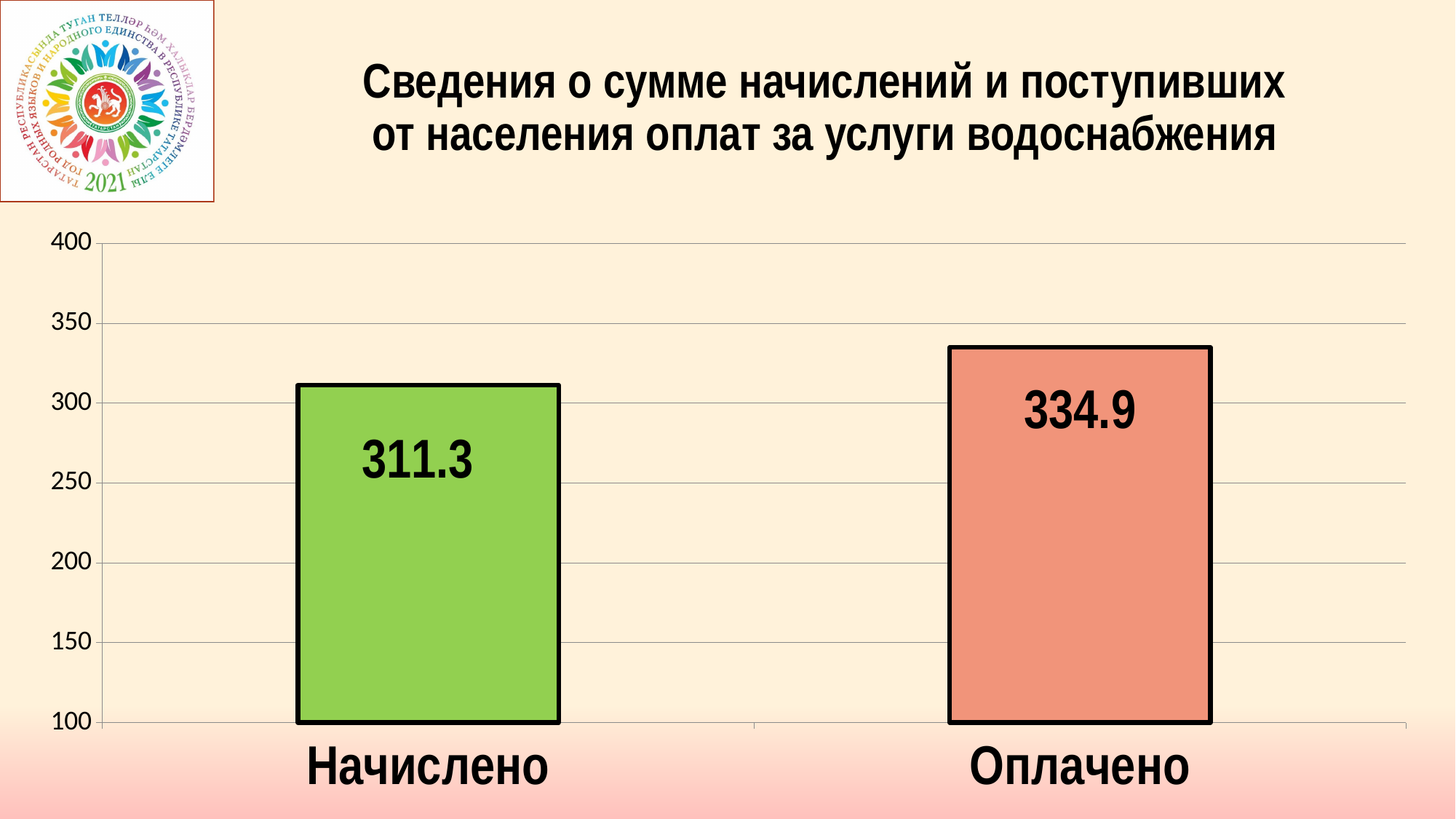
Which category has the highest value? Оплачено What kind of chart is shown on the slide? Bar chart Is the value for Начислено greater or less than 300? greater What is the value for Оплачено? 334.9 Which category has the lowest value? Начислено Is the value for Оплачено greater or less than 350? less Which is larger, the value for Начислено or the value for Оплачено? Оплачено What is the highest value shown on the vertical axis? 400 How many categories are shown in the chart? 2 What colour is the bar for Начислено? Green What is the value for Начислено? 311.3 What is the difference between the values for Оплачено and Начислено? 23.6